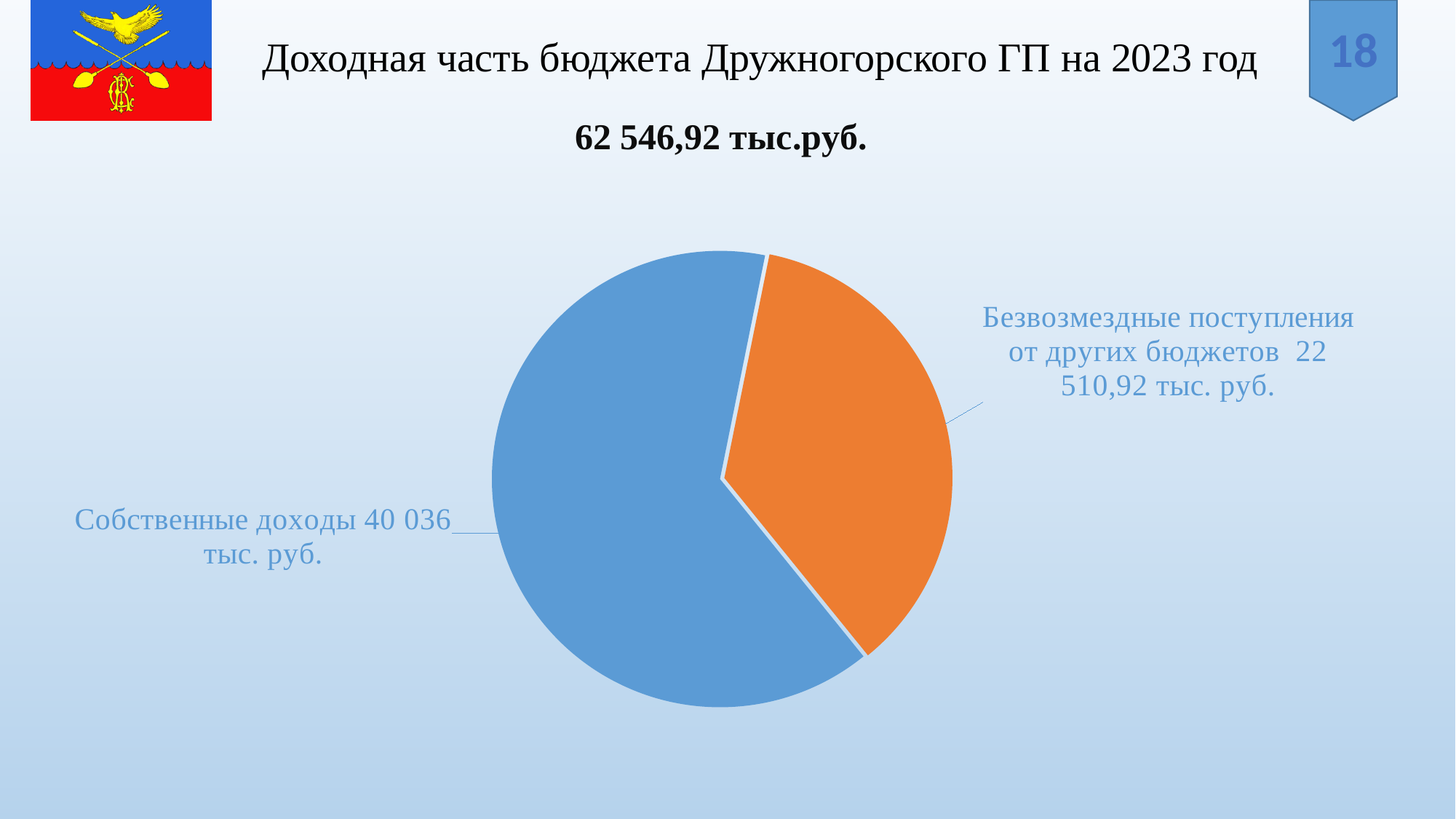
What is the total of the two slices in the pie chart? 62 546,92 тыс. руб. What is the value for Собственные доходы? 40 036 тыс. руб. What kind of chart is shown on the slide? Pie chart What is the value for Безвозмездные поступления от других бюджетов? 22 510,92 тыс. руб. What share of the pie does Собственные доходы represent? 64% What is the difference between Собственные доходы and Безвозмездные поступления от других бюджетов? 17 525,08 тыс. руб. Which is larger: Собственные доходы or Безвозмездные поступления от других бюджетов? Собственные доходы Which slice of the pie is the smallest? Безвозмездные поступления от других бюджетов What colour is the slice for Безвозмездные поступления от других бюджетов? Orange Which slice of the pie is the largest? Собственные доходы How many slices does the pie chart have? 2 What share of the pie does Безвозмездные поступления от других бюджетов represent? 36%